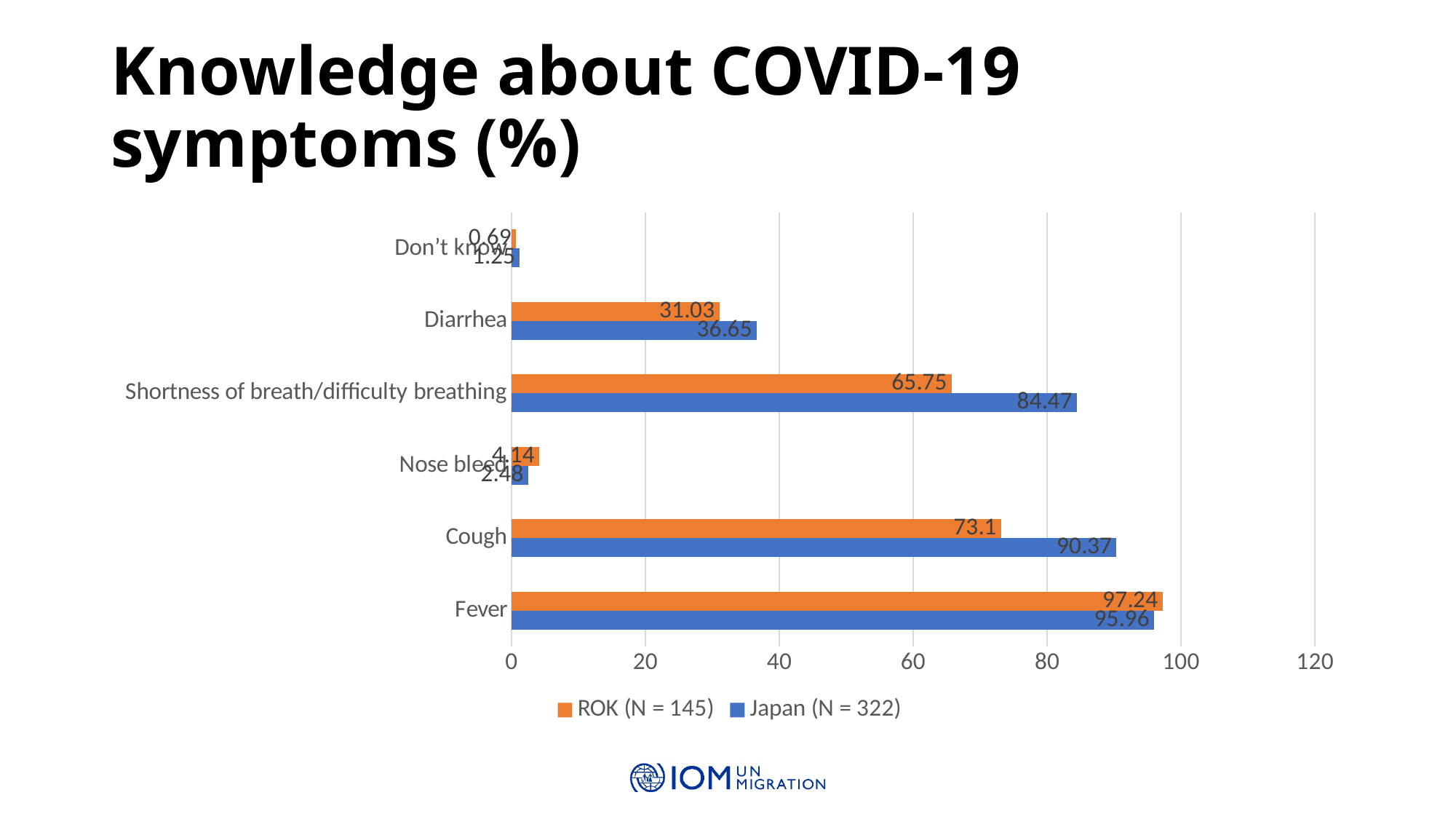
What is the value for Shortness of breath/difficulty breathing in the Japan (N = 322) series? 84.47 For Shortness of breath/difficulty breathing, which series has the larger value, ROK (N = 145) or Japan (N = 322)? Japan (N = 322) What kind of chart is shown on the slide? Bar chart What is the difference between the Japan (N = 322) and ROK (N = 145) values for Cough? 17.27 How many symptom categories are shown on the chart? 6 Which colour represents the ROK (N = 145) series? Orange Which category has the highest value in the Japan (N = 322) series? Fever What is the value for Cough in the Japan (N = 322) series? 90.37 What is the value for Fever in the ROK (N = 145) series? 97.24 Which category has the lowest value in the ROK (N = 145) series? Don't know How many series does the legend list? 2 What is the value for Diarrhea in the ROK (N = 145) series? 31.03